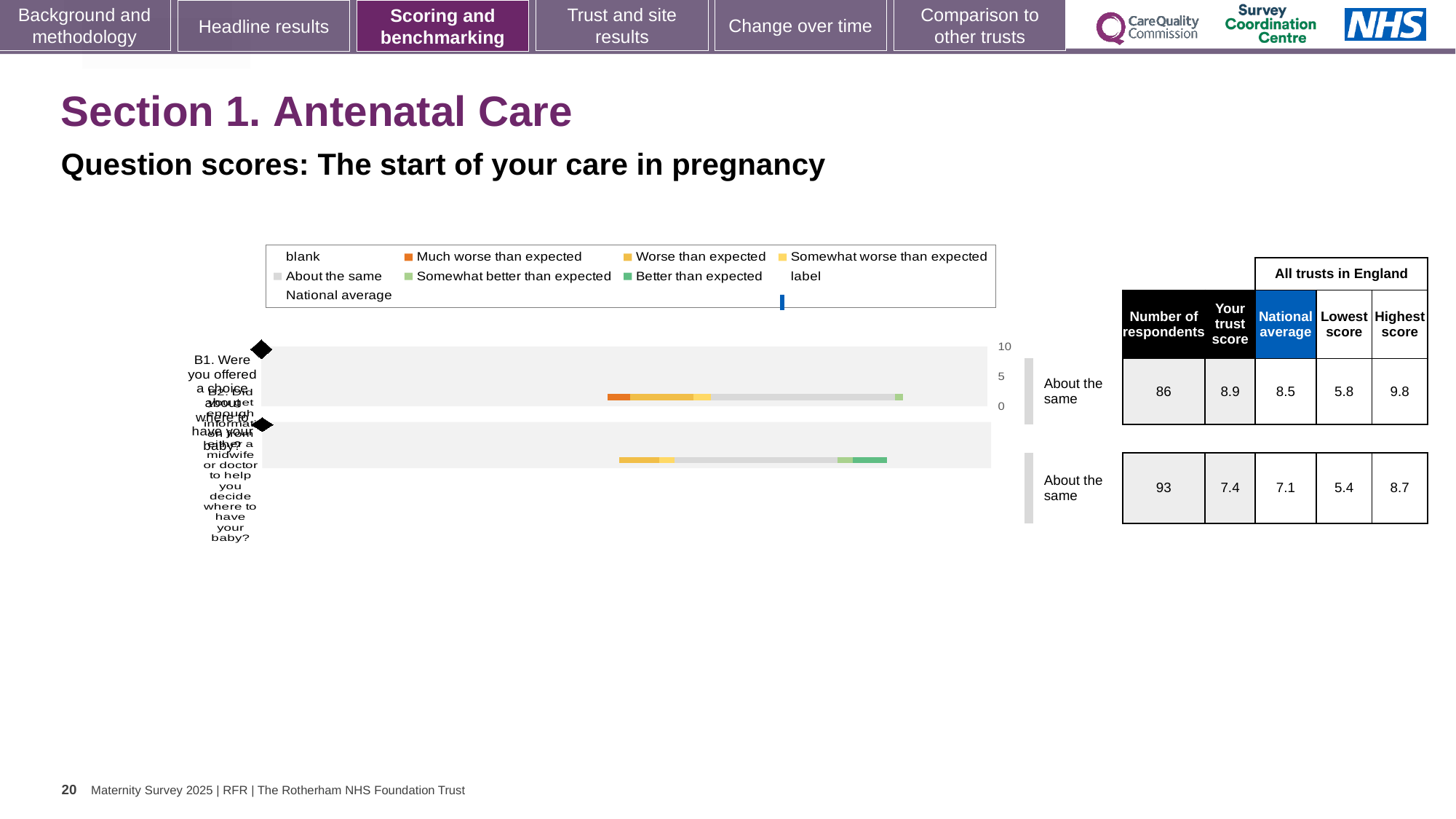
How many questions (bars) are plotted in the chart? 2 What is the trust score for question B1? 8.9 What kind of chart is shown on the slide? bar chart Which question has the higher trust score, B1 or B2? B1 What is the lowest score across all trusts in England for question B2? 5.4 What is the difference between the highest and lowest scores for question B2? 3.3 What is the number of respondents for question B1? 86 What is the difference between the trust score and the national average for question B1? 0.4 What is the national average for question B2? 7.1 What colour represents 'Much worse than expected' in the legend? orange What benchmark category is shown for question B2? About the same What is the highest score across all trusts in England for question B1? 9.8